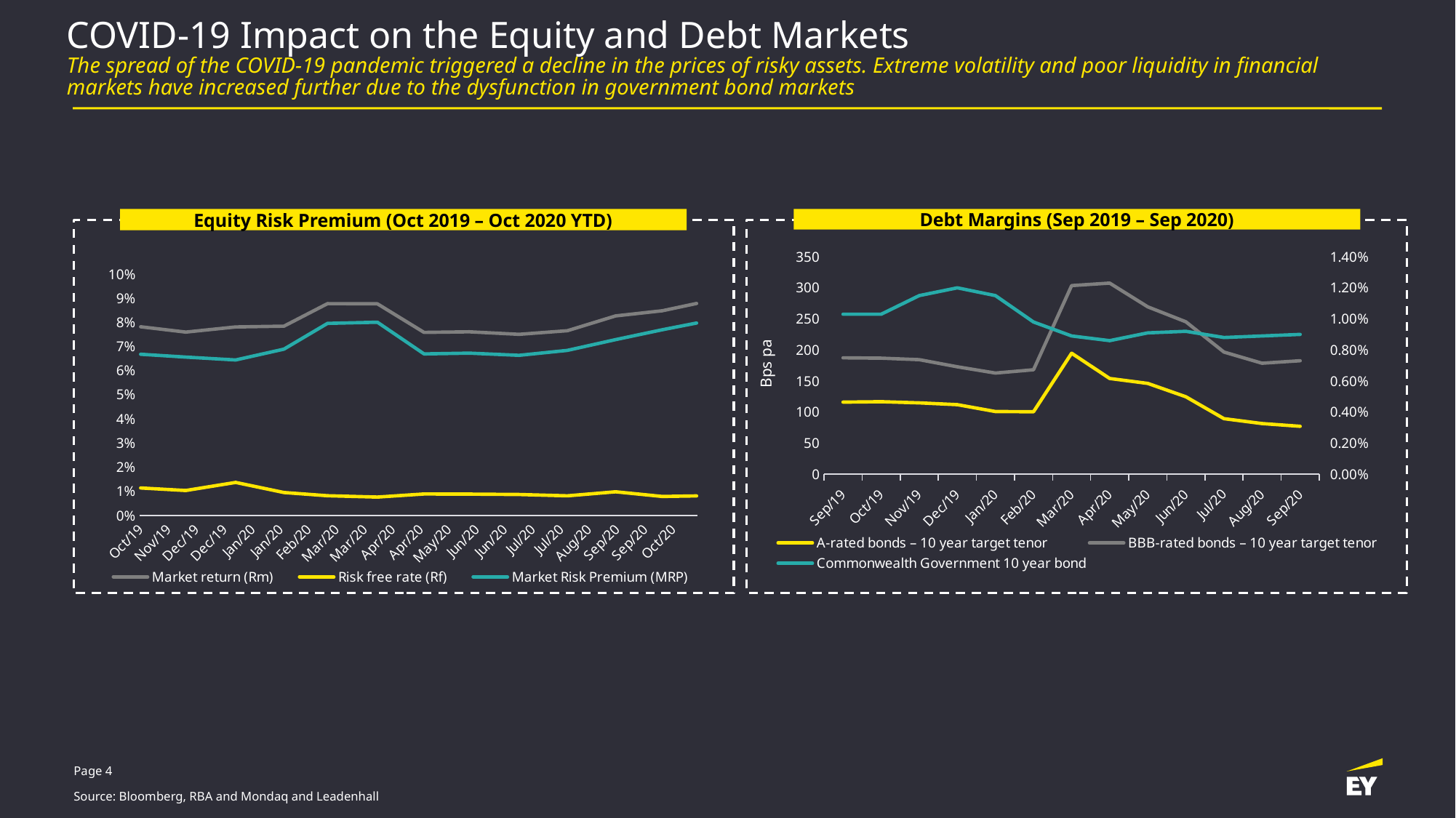
How many series does the legend of the Debt Margins (Sep 2019 – Sep 2020) chart list? 3 In the Debt Margins chart, how many months are shown on the x axis? 13 In the Equity Risk Premium chart, is the value for Market return (Rm) at Mar/20 greater or less than 8%? greater In the Debt Margins chart, is the value for BBB-rated bonds – 10 year target tenor at Apr/20 greater or less than 250 Bps pa? greater What is the label on the left vertical axis of the Debt Margins chart? Bps pa What type of chart is the Equity Risk Premium (Oct 2019 – Oct 2020 YTD) chart? Line chart In the Debt Margins chart, does the A-rated bonds – 10 year target tenor series rise or fall from Mar/20 to Sep/20? Fall In the Debt Margins chart, is the value for A-rated bonds – 10 year target tenor at Sep/20 greater or less than 100 Bps pa? less In the Debt Margins chart, at which month does the A-rated bonds – 10 year target tenor series reach its highest value? Mar/20 In the Equity Risk Premium chart, which series is higher at Oct/20: Market return (Rm) or Risk free rate (Rf)? Market return (Rm) In the Debt Margins chart, at which month is the A-rated bonds – 10 year target tenor series at its lowest value? Sep/20 How many series does the legend of the Equity Risk Premium chart list? 3